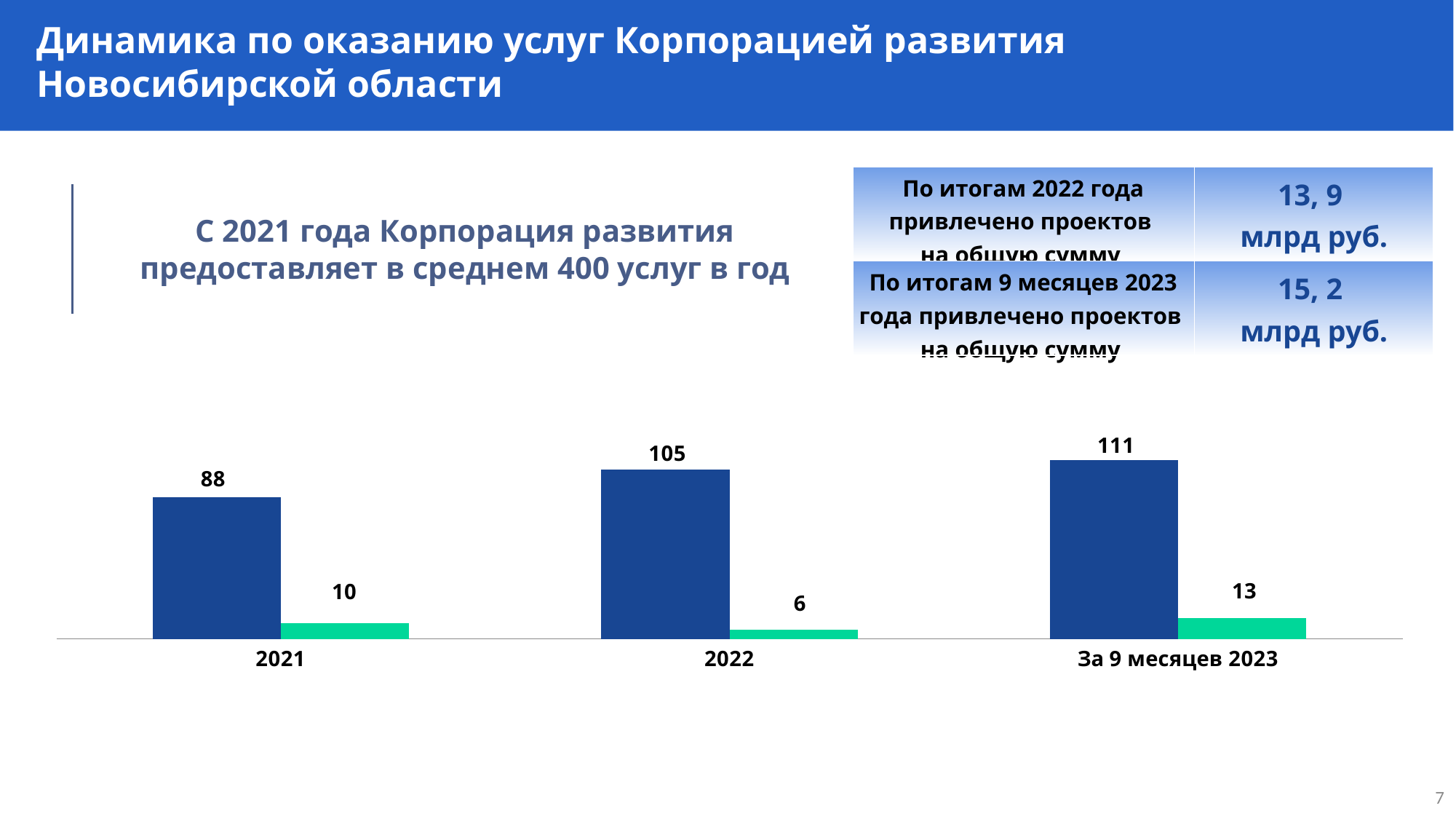
Which category has the lowest green bar? 2022 What is the value of the green bar for 2022? 6 How many categories are shown on the x axis of the chart? 3 What is the value of the green bar for 2021? 10 What is the total of the dark blue and green bars for 2022? 111 What is the difference between the dark blue bars for 2022 and 2021? 17 Do the dark blue bars rise or fall from 2021 to 'За 9 месяцев 2023'? Rise What is the value of the dark blue bar for 'За 9 месяцев 2023'? 111 Which category has the highest dark blue bar? За 9 месяцев 2023 What kind of chart is shown on the slide? Bar chart Which is larger: the green bar for 2021 or the green bar for 'За 9 месяцев 2023'? За 9 месяцев 2023 What is the value of the dark blue bar for 2021? 88